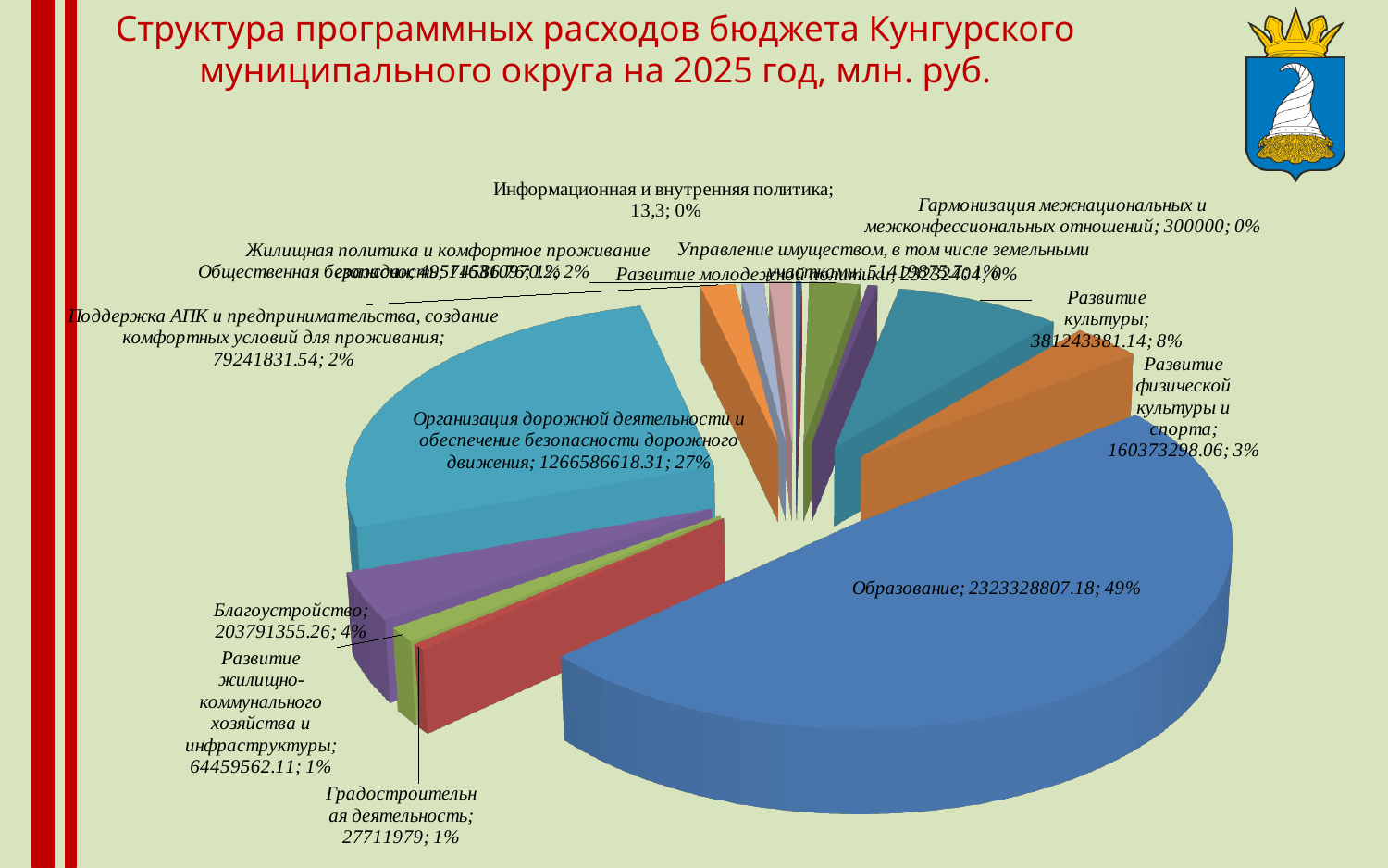
What is the value shown for Развитие культуры? 381243381.14 What share of the pie does Организация дорожной деятельности и обеспечение безопасности дорожного движения represent? 27% What is the value shown for Градостроительная деятельность? 27711979 Which is larger: Развитие культуры or Развитие физической культуры и спорта? Развитие культуры What kind of chart is shown on the slide? pie chart What share of the pie does Образование represent? 49% What is the value shown for Благоустройство? 203791355.26 What is the value shown for Образование? 2323328807.18 What share of the pie does Поддержка АПК и предпринимательства, создание комфортных условий для проживания represent? 2% What is the title of the chart on the slide? Структура программных расходов бюджета Кунгурского муниципального округа на 2025 год, млн. руб. What is the difference in percentage share between Образование and Организация дорожной деятельности и обеспечение безопасности дорожного движения? 22 percentage points Which category has the largest slice of the pie? Образование